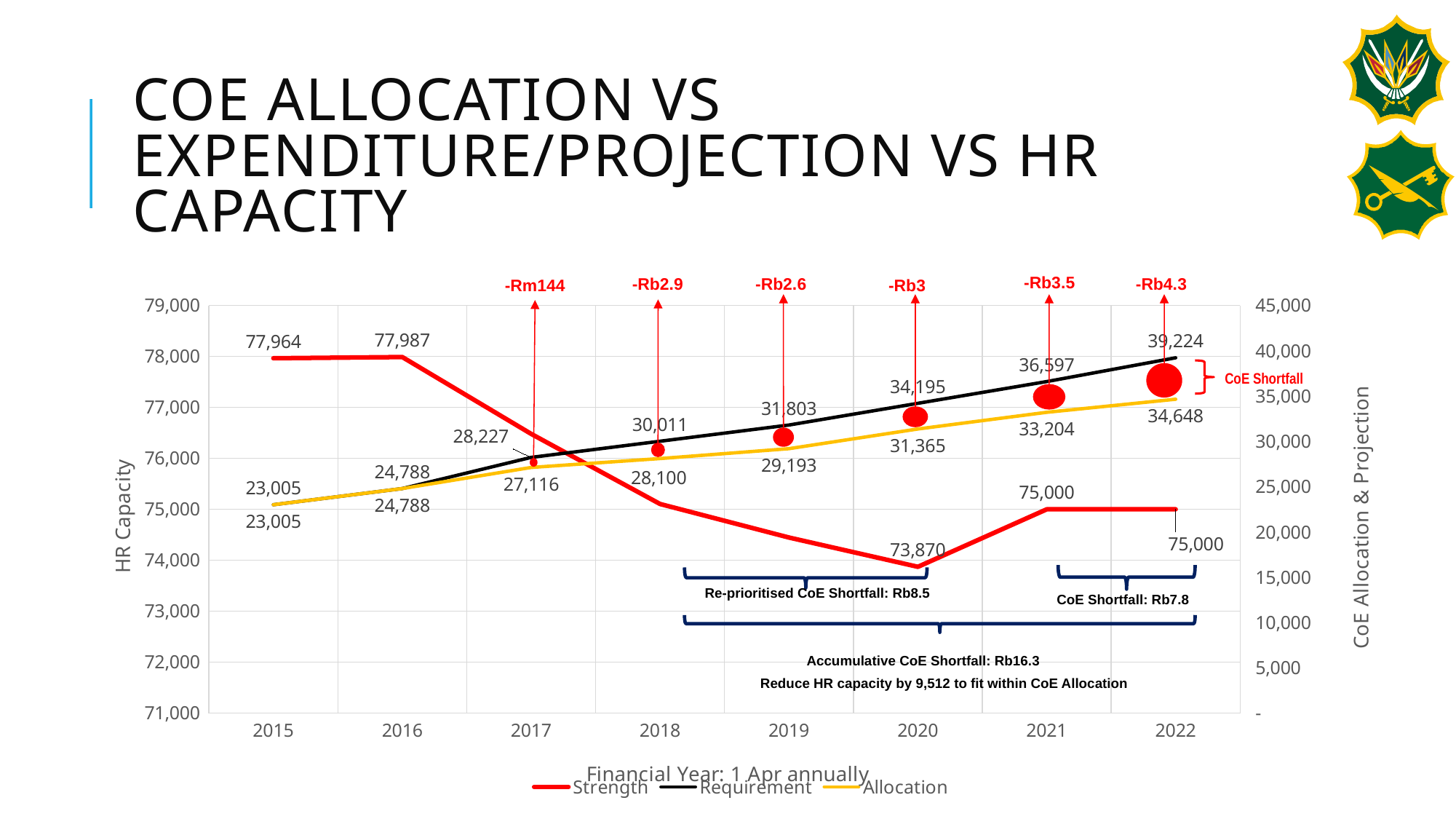
Which is larger in 2019, the Requirement value or the Allocation value? Requirement What type of chart is shown on the slide? line chart How many series does the legend list? 3 What is the Strength value for 2020? 73,870 How many years are shown on the x axis? 8 What is the Requirement value for 2022? 39,224 In which year is the Allocation value lowest? 2015 What is the difference between the Requirement and Allocation values in 2021? 3,393 What is the Strength value for 2015? 77,964 In which year is the Requirement value highest? 2022 What is the Allocation value for 2020? 31,365 Does the Requirement series rise or fall from 2015 to 2022? rise